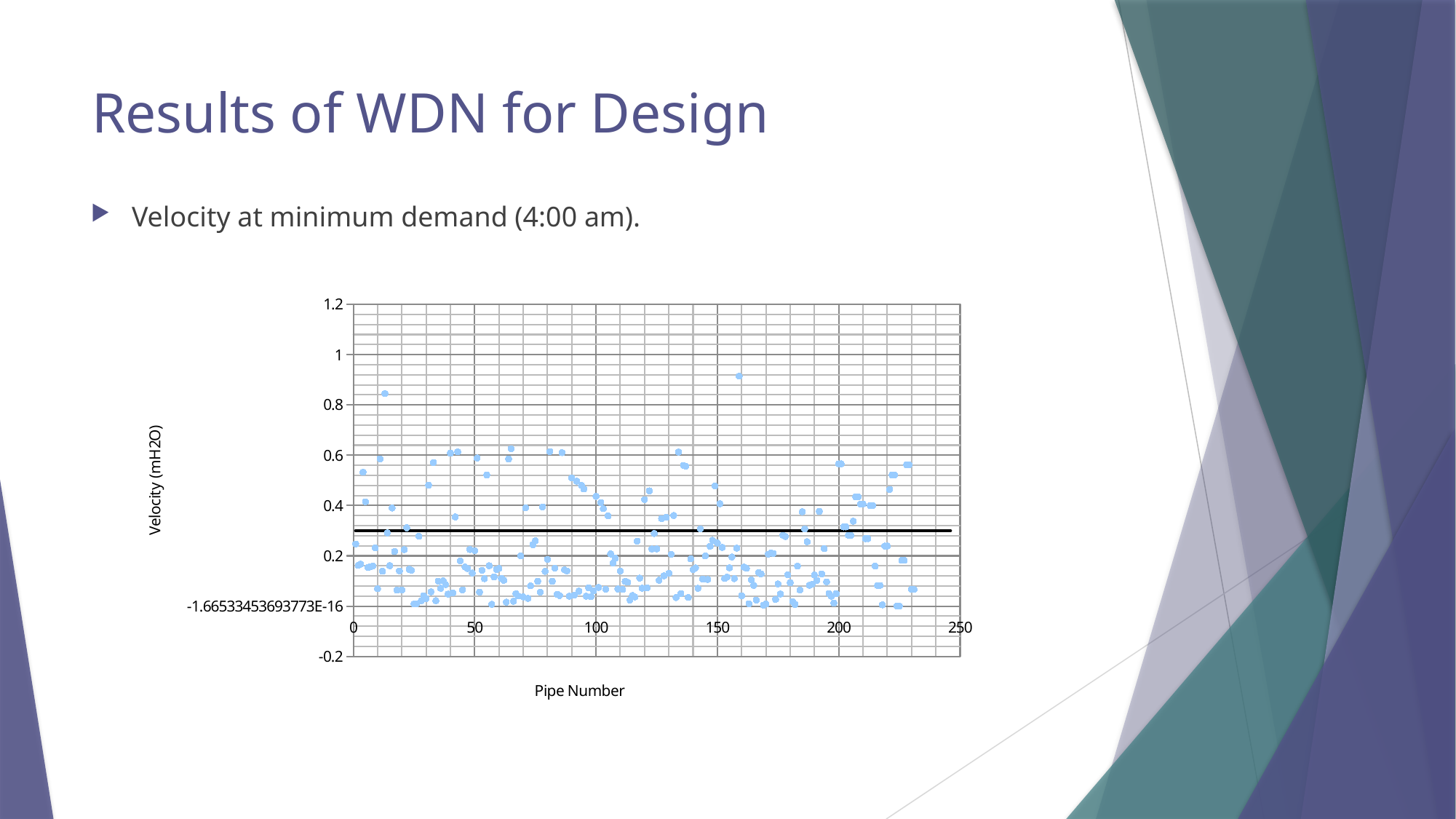
Is the highest plotted velocity value in the chart greater or less than 1? less What is the title of the x axis of the chart? Pipe Number What is the largest tick value shown on the x axis of the chart? 250 What is the highest value shown on the y axis of the chart? 1.2 Is the horizontal black line in the chart greater or less than 0.4 on the y axis? less Are the plotted points in the chart located at pipe numbers greater or less than 250? less What is the lowest value shown on the y axis of the chart? -0.2 What kind of chart is shown on the slide? Scatter chart What is the title of the y axis of the chart? Velocity (mH2O)